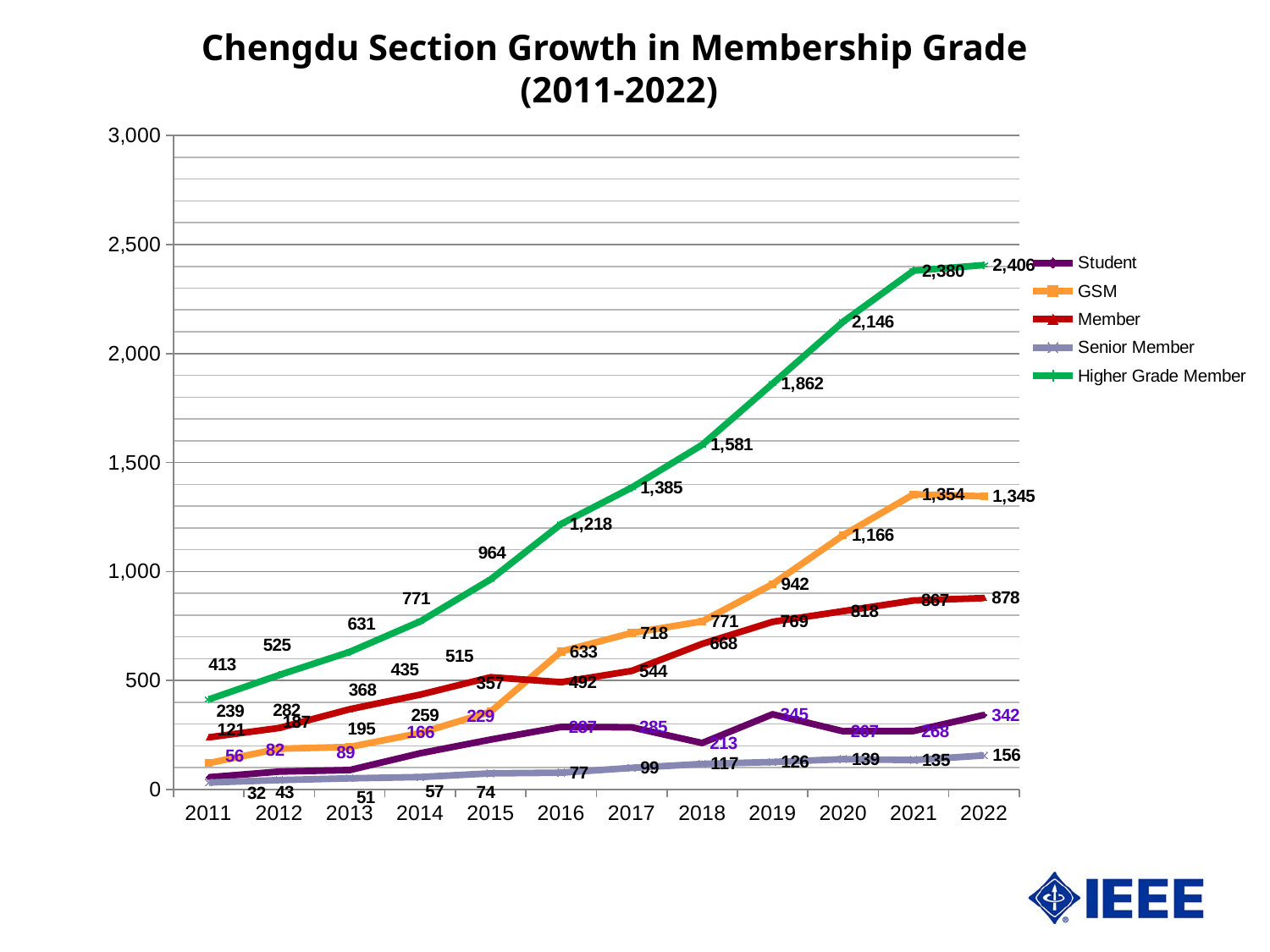
What is the value for Higher Grade Member in 2022? 2,406 What kind of chart is shown on the slide? Line chart What is the value for Senior Member in 2022? 156 How many years are plotted on the x axis? 12 In which year is the Senior Member value lowest? 2011 How many series does the legend list? 5 What is the value for Member in 2018? 668 In which year is the Higher Grade Member value highest? 2022 In 2019, which is larger: GSM or Member? GSM What is the value for Student in 2019? 345 What is the value for GSM in 2021? 1,354 What is the difference between the Higher Grade Member values in 2022 and 2021? 26